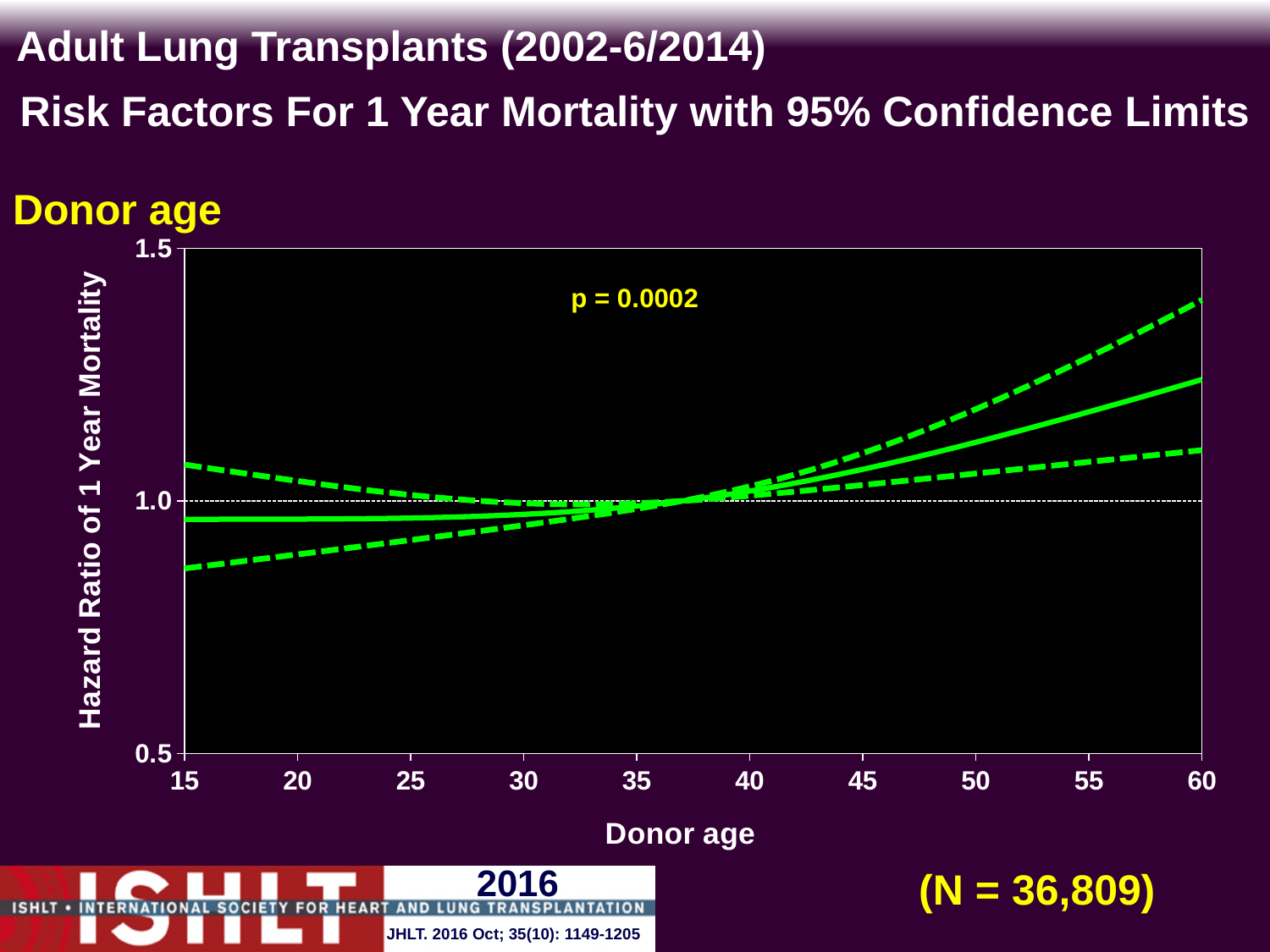
What kind of chart is shown on the slide? line chart Is the upper 95% confidence limit at donor age 60 greater or less than 1.0? greater Is the hazard ratio (solid line) at donor age 60 greater or less than 1.0? greater How many lines are plotted on the chart? 3 What is the highest value labelled on the y axis? 1.5 Is the upper 95% confidence limit at donor age 60 greater or less than 1.5? less What is the p-value printed on the chart? p = 0.0002 What is the label of the y axis? Hazard Ratio of 1 Year Mortality How many tick labels are shown on the donor age (x) axis? 10 Does the hazard ratio (solid line) rise or fall as donor age increases from 40 to 60? rise